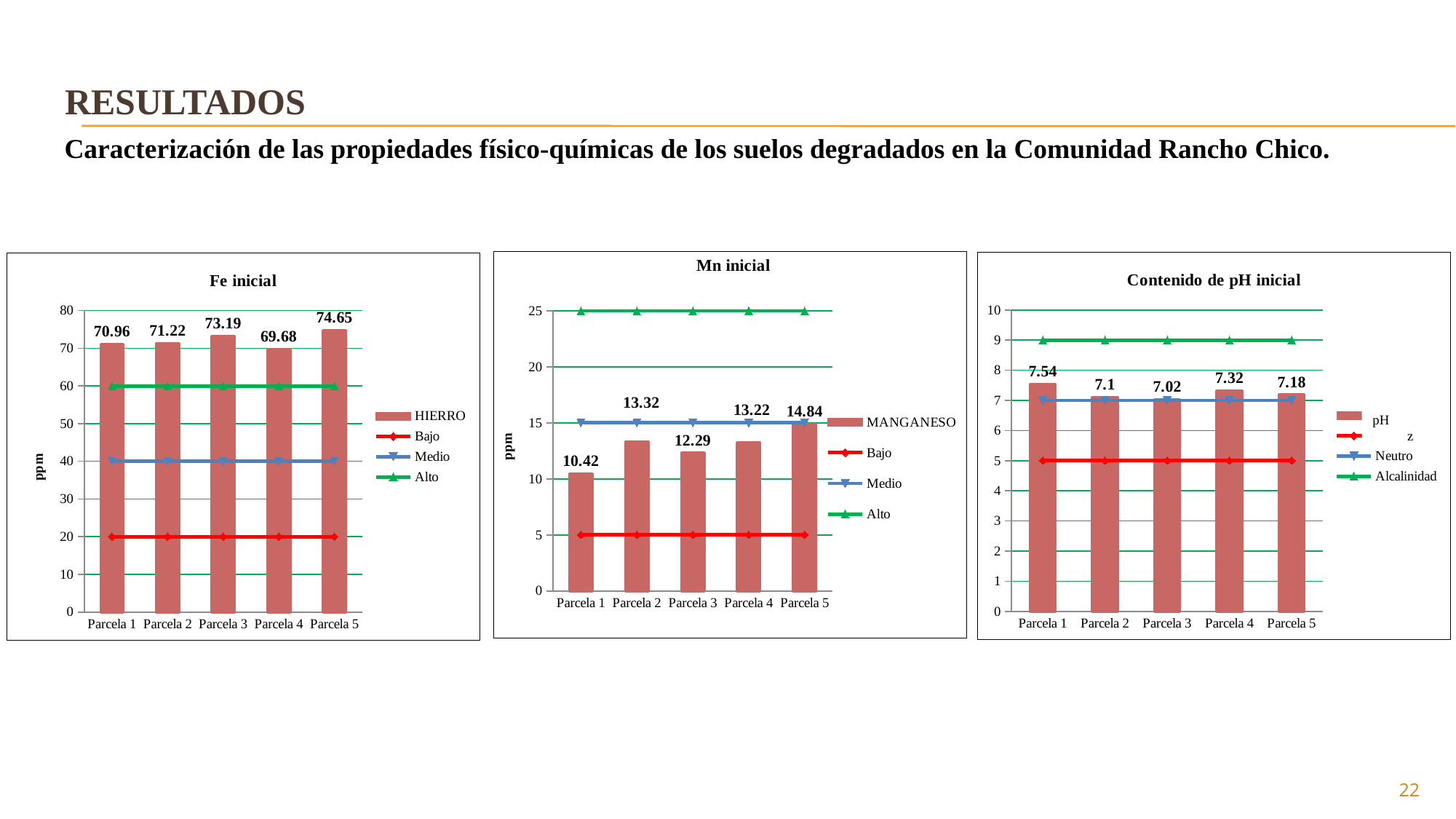
In the 'Fe inicial' chart, what is the value for Parcela 3? 73.19 In the 'Mn inicial' chart, how many series does the legend list? 4 In the 'Fe inicial' chart, what is the difference between the values for Parcela 5 and Parcela 4? 4.97 In the 'Mn inicial' chart, which is larger, the value for Parcela 2 or Parcela 3? Parcela 2 In the 'Mn inicial' chart, which parcela has the highest MANGANESO value? Parcela 5 In the 'Fe inicial' chart, which parcela has the lowest HIERRO value? Parcela 4 In the 'Contenido de pH inicial' chart, which parcela has the lowest pH value? Parcela 3 What is the y-axis label of the 'Fe inicial' chart? ppm In the 'Contenido de pH inicial' chart, how many parcelas are shown on the x axis? 5 In the 'Mn inicial' chart, what is the value for Parcela 1? 10.42 In the 'Contenido de pH inicial' chart, what is the value for Parcela 1? 7.54 In the 'Fe inicial' chart, which parcela has the highest HIERRO value? Parcela 5